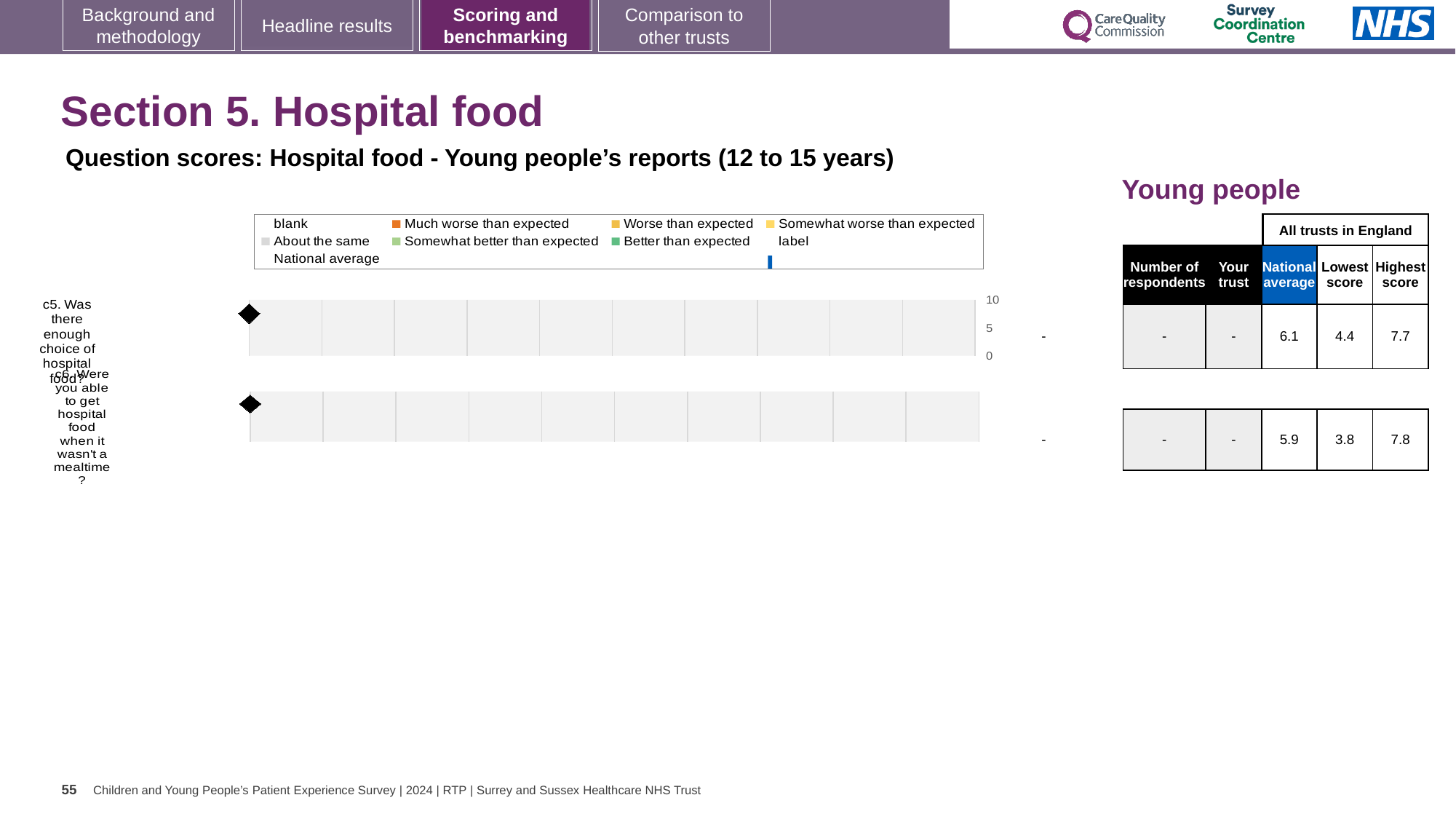
In the table, what is the highest score for c6? 7.8 What is the highest value shown on the chart's vertical axis? 10 In the table, what is the national average score for c5 (Was there enough choice of hospital food?)? 6.1 What kind of chart is used on the slide for the hospital food question scores? bar chart In the table, what is the lowest score across all trusts in England for c5? 4.4 In the table, what is the lowest score for c6? 3.8 How many questions (categories) are plotted on the chart? 2 In the table, what is the national average score for c6 (Were you able to get hospital food when it wasn't a mealtime?)? 5.9 In the table, what is the highest score across all trusts in England for c5? 7.7 What is the difference between the highest score and the lowest score for c5 in the table? 3.3 Which question has the higher national average score, c5 or c6? c5